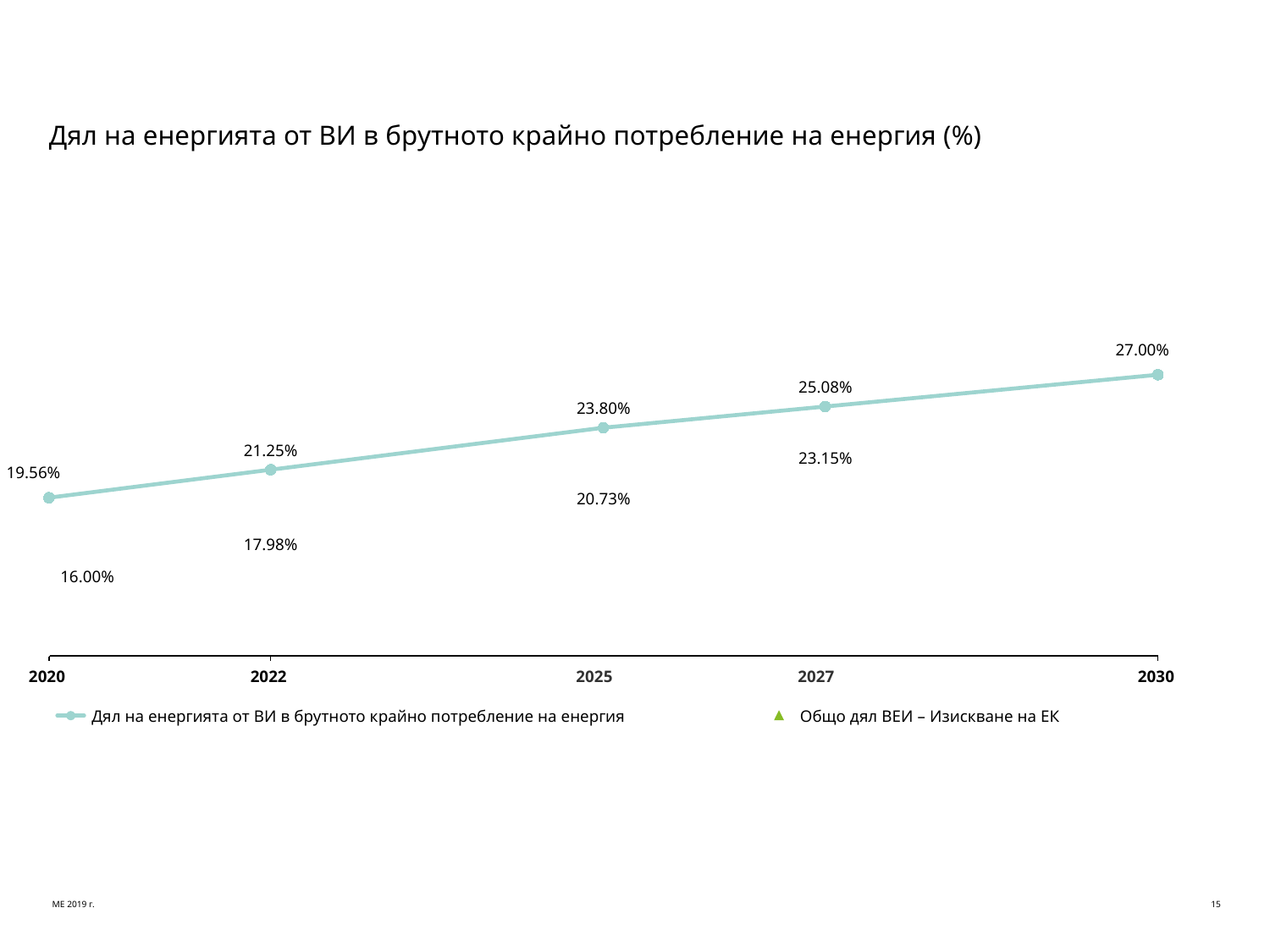
What is the value of the series 'Дял на енергията от ВИ в брутното крайно потребление на енергия' for 2030? 27.00% For 2027, which is larger: the value of 'Дял на енергията от ВИ в брутното крайно потребление на енергия' or the value of 'Общо дял ВЕИ – Изискване на ЕК'? Дял на енергията от ВИ в брутното крайно потребление на енергия In which year does the series 'Дял на енергията от ВИ в брутното крайно потребление на енергия' reach its highest value? 2030 What is the difference between the 2030 and 2020 values of the series 'Дял на енергията от ВИ в брутното крайно потребление на енергия'? 7.44% What is the value of the series 'Дял на енергията от ВИ в брутното крайно потребление на енергия' for 2020? 19.56% In which year is the series 'Дял на енергията от ВИ в брутното крайно потребление на енергия' at its lowest value? 2020 How many series does the legend list? 2 What is the value of the series 'Общо дял ВЕИ – Изискване на ЕК' for 2020? 16.00% How many years are shown on the x axis? 5 Does the series 'Дял на енергията от ВИ в брутното крайно потребление на енергия' rise or fall from 2020 to 2030? Rise What kind of chart is shown on the slide? Line chart What is the value of the series 'Общо дял ВЕИ – Изискване на ЕК' for 2025? 20.73%